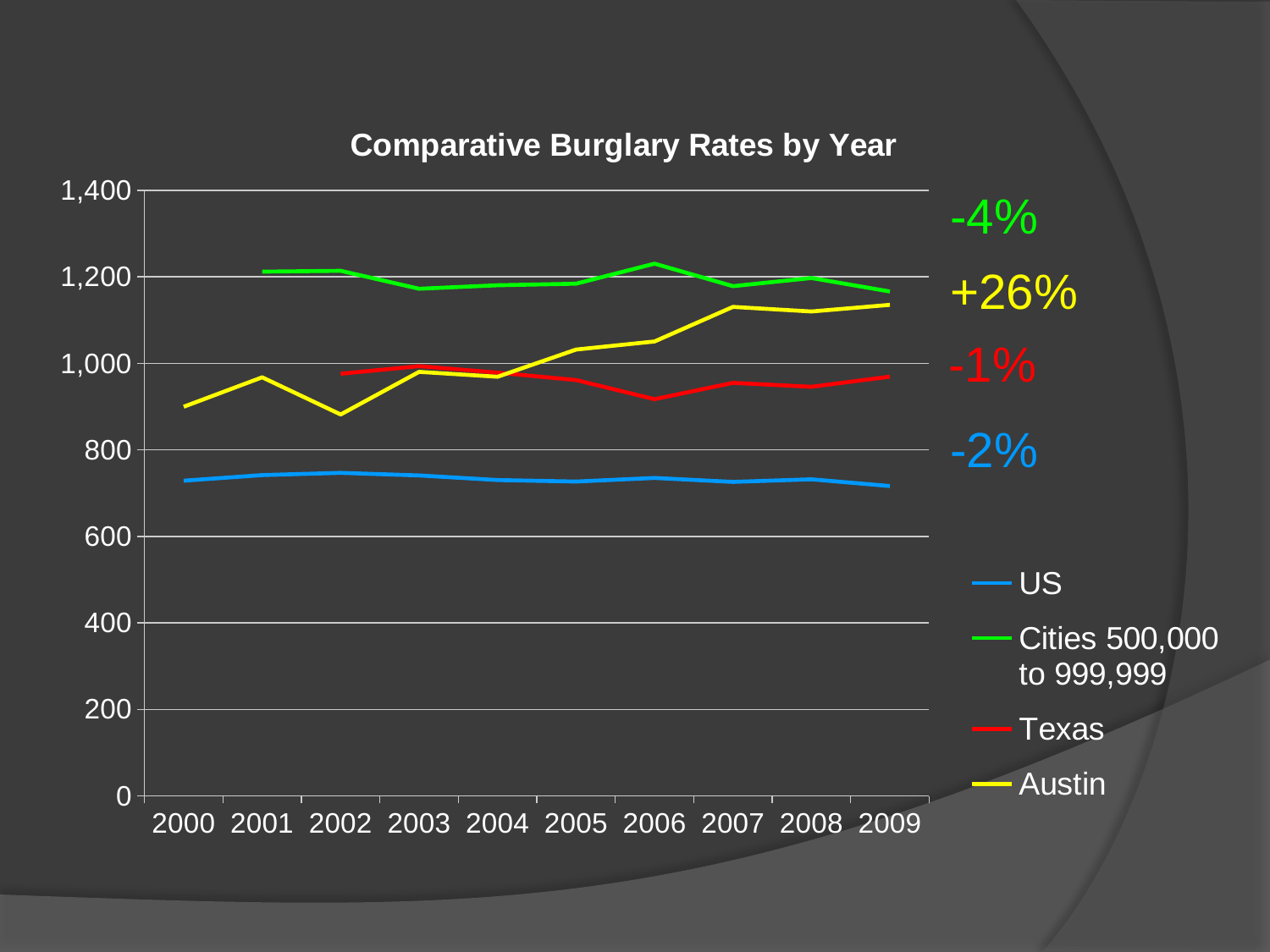
What is the title of the chart? Comparative Burglary Rates by Year Is the value for Texas in 2006 greater or less than 1,000? less Which series has the lowest value in 2009? US Is the value for US in 2000 greater or less than 800? less How many series does the legend list? 4 Is the value for Austin in 2009 greater or less than 1,000? greater What percentage change is shown next to the chart for the Austin (yellow) series? +26% Which series has the highest value in 2009? Cities 500,000 to 999,999 How many years are shown on the x axis? 10 Does the Austin line rise or fall from 2000 to 2009? rise In 2009, which is larger: the value for Austin or the value for Texas? Austin What kind of chart is shown on the slide? line chart